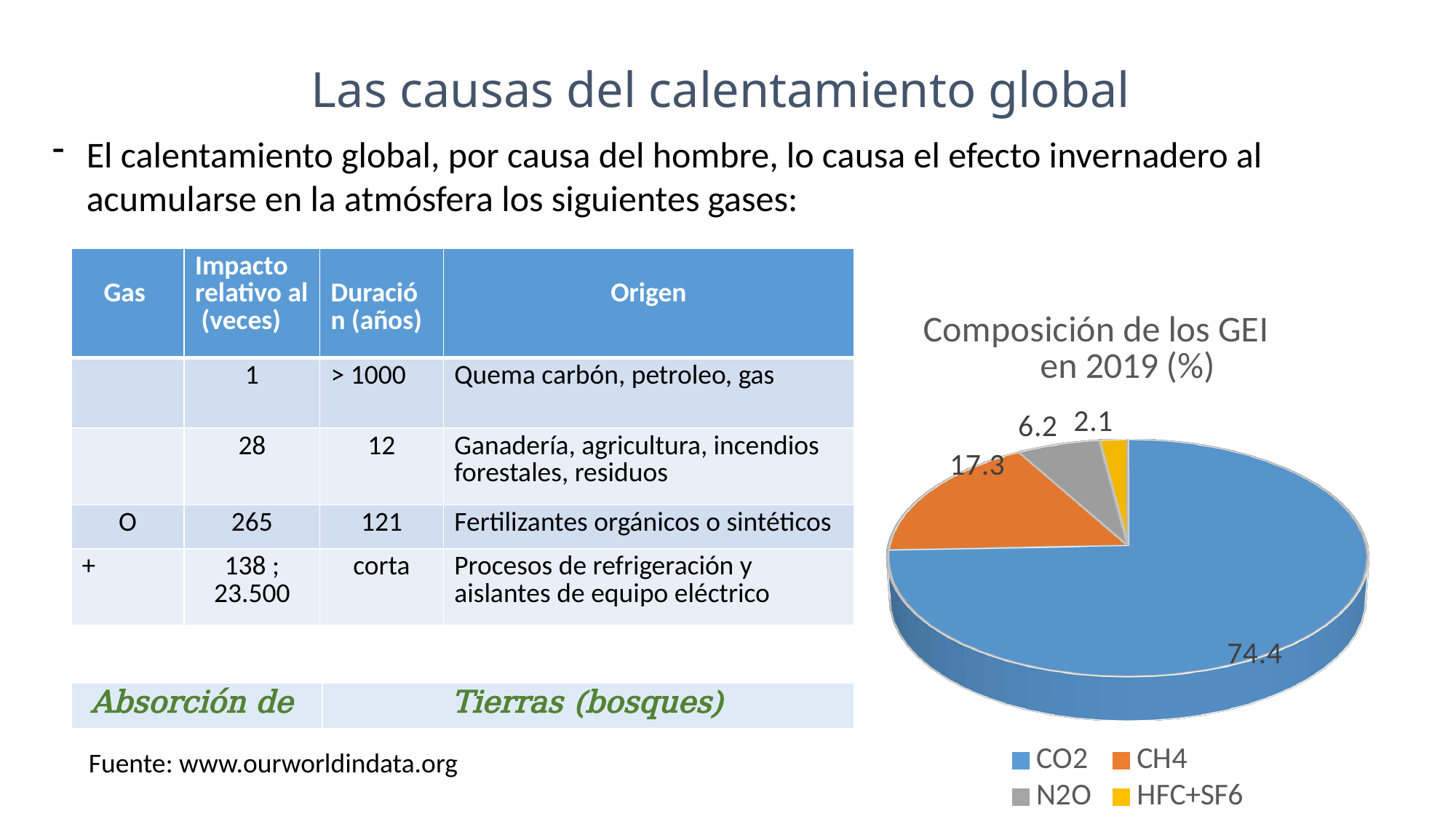
What is the value for CH4 in the pie chart? 17.3 How many slices does the pie chart have? 4 Which gas has the smallest slice in the pie chart? HFC+SF6 What is the difference between the CO2 and CH4 values in the pie chart? 57.1 What is the value for N2O in the pie chart? 6.2 Which is larger in the pie chart, the value for N2O or the value for HFC+SF6? N2O What is the value for HFC+SF6 in the pie chart? 2.1 What kind of chart is shown on the slide? pie chart What is the title of the pie chart? Composición de los GEI en 2019 (%) What is the value for CO2 in the pie chart? 74.4 How many entries does the legend of the pie chart list? 4 Which gas has the largest slice in the pie chart? CO2